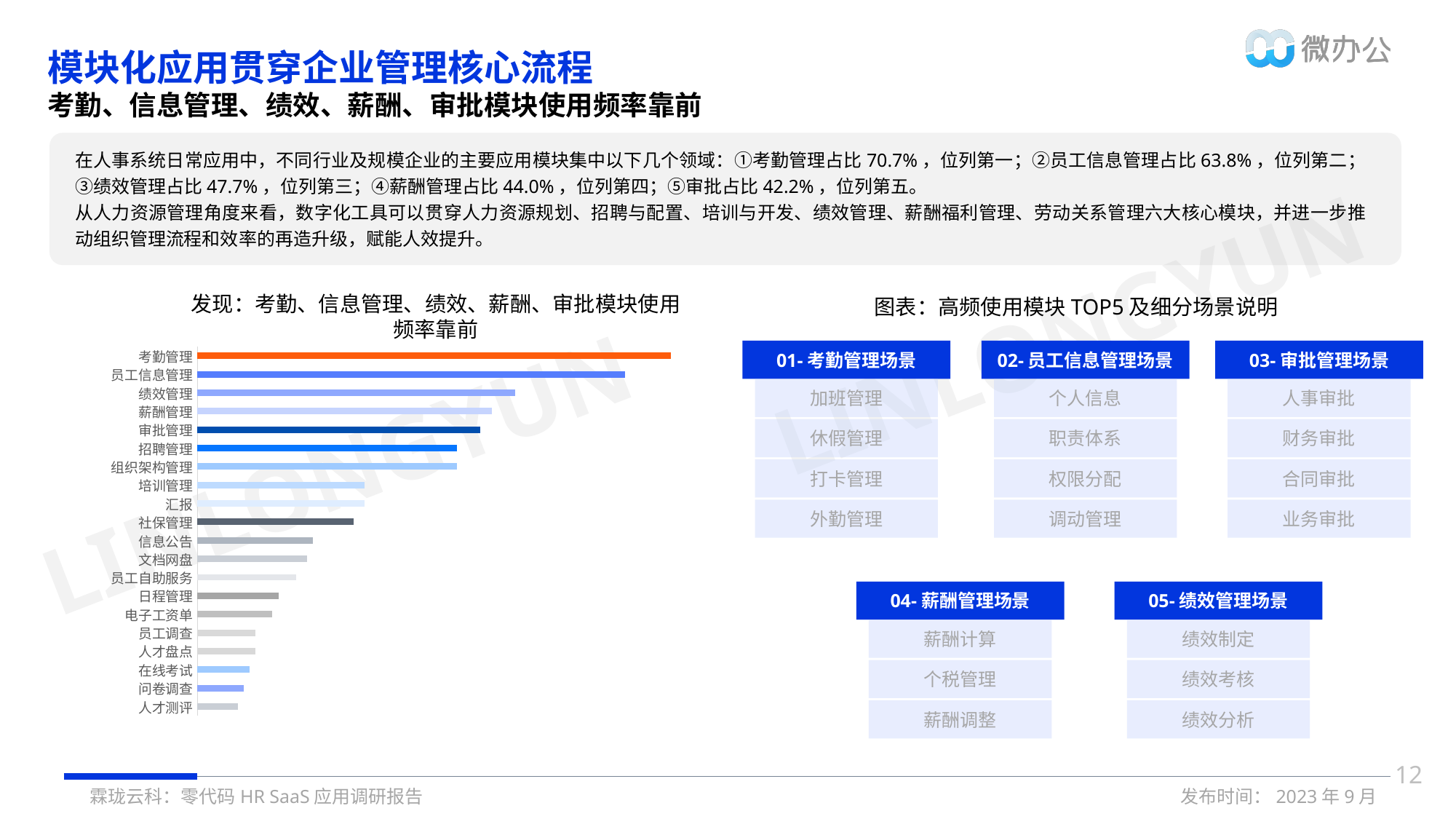
What colour is the bar for 考勤管理 in the bar chart? orange In the bar chart, which has the longer bar: 绩效管理 or 薪酬管理? 绩效管理 According to the slide, what share does 考勤管理 account for? 70.7% According to the slide, what share does 绩效管理 account for? 47.7% What is the difference in percentage points between 考勤管理 (70.7%) and 员工信息管理 (63.8%)? 6.9 In the bar chart, which module has the longest bar? 考勤管理 According to the slide, what share does 审批 account for? 42.2% In the bar chart, which has the longer bar: 招聘管理 or 社保管理? 招聘管理 How many modules (categories) are listed in the bar chart? 20 What kind of chart is shown on the left of the slide? bar chart According to the slide, what share does 薪酬管理 account for? 44.0% According to the slide, what share does 员工信息管理 account for? 63.8%